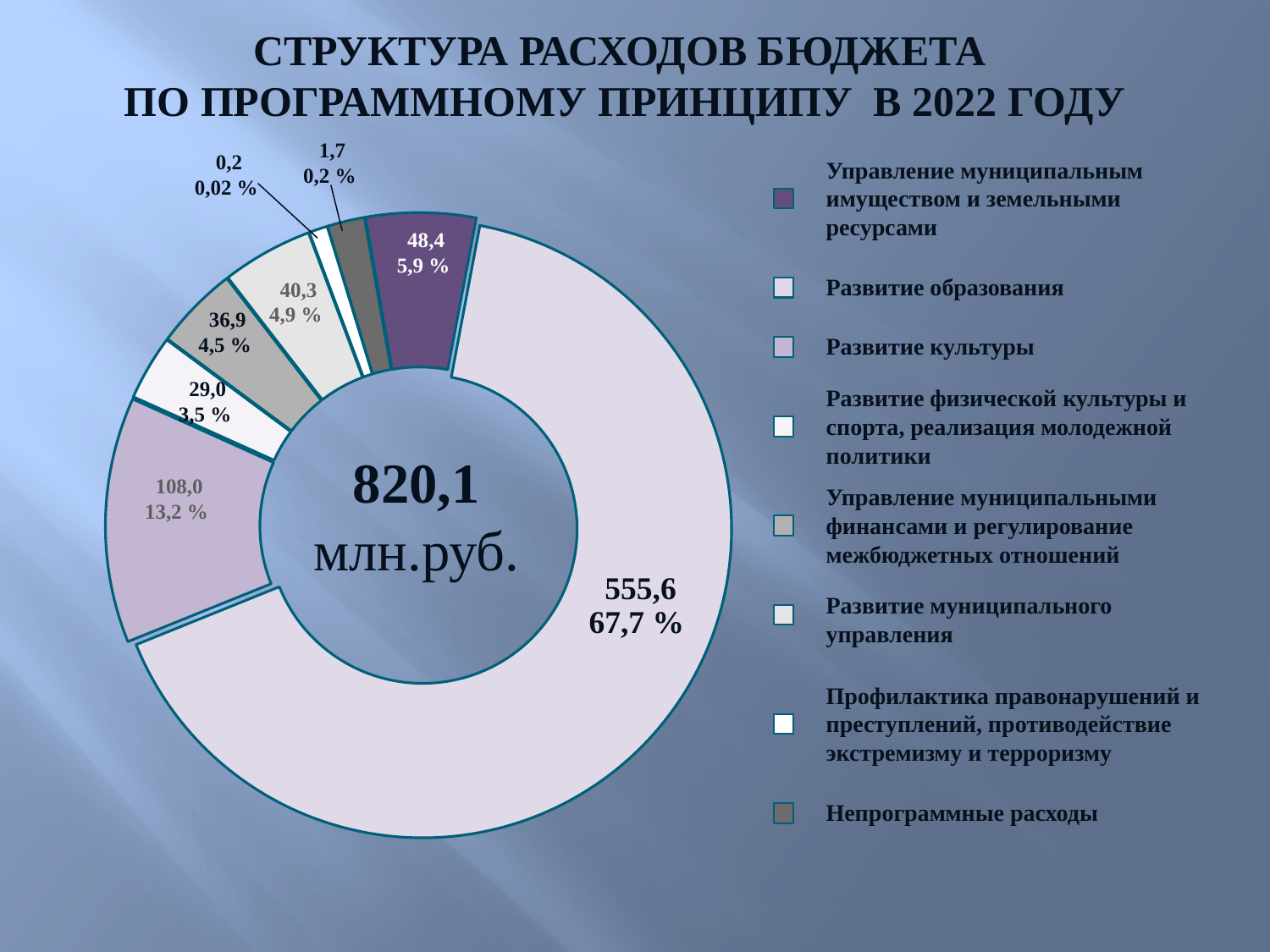
How many categories does the legend list? 8 Which is larger, the value for Развитие муниципального управления or for Управление муниципальными финансами и регулирование межбюджетных отношений? Развитие муниципального управления What kind of chart is shown on the slide? Doughnut (pie) chart What total is shown in the centre of the chart? 820,1 млн.руб. What is the value for Непрограммные расходы? 1,7 Which category has the smallest slice? Профилактика правонарушений и преступлений, противодействие экстремизму и терроризму What is the value for Развитие культуры? 108,0 What is the value for Развитие образования? 555,6 What share of the total does Развитие образования account for? 67,7 % What percentage is shown for Управление муниципальным имуществом и земельными ресурсами? 5,9 % What is the difference between the values for Развитие культуры and Управление муниципальным имуществом и земельными ресурсами? 59,6 Which category has the largest slice? Развитие образования